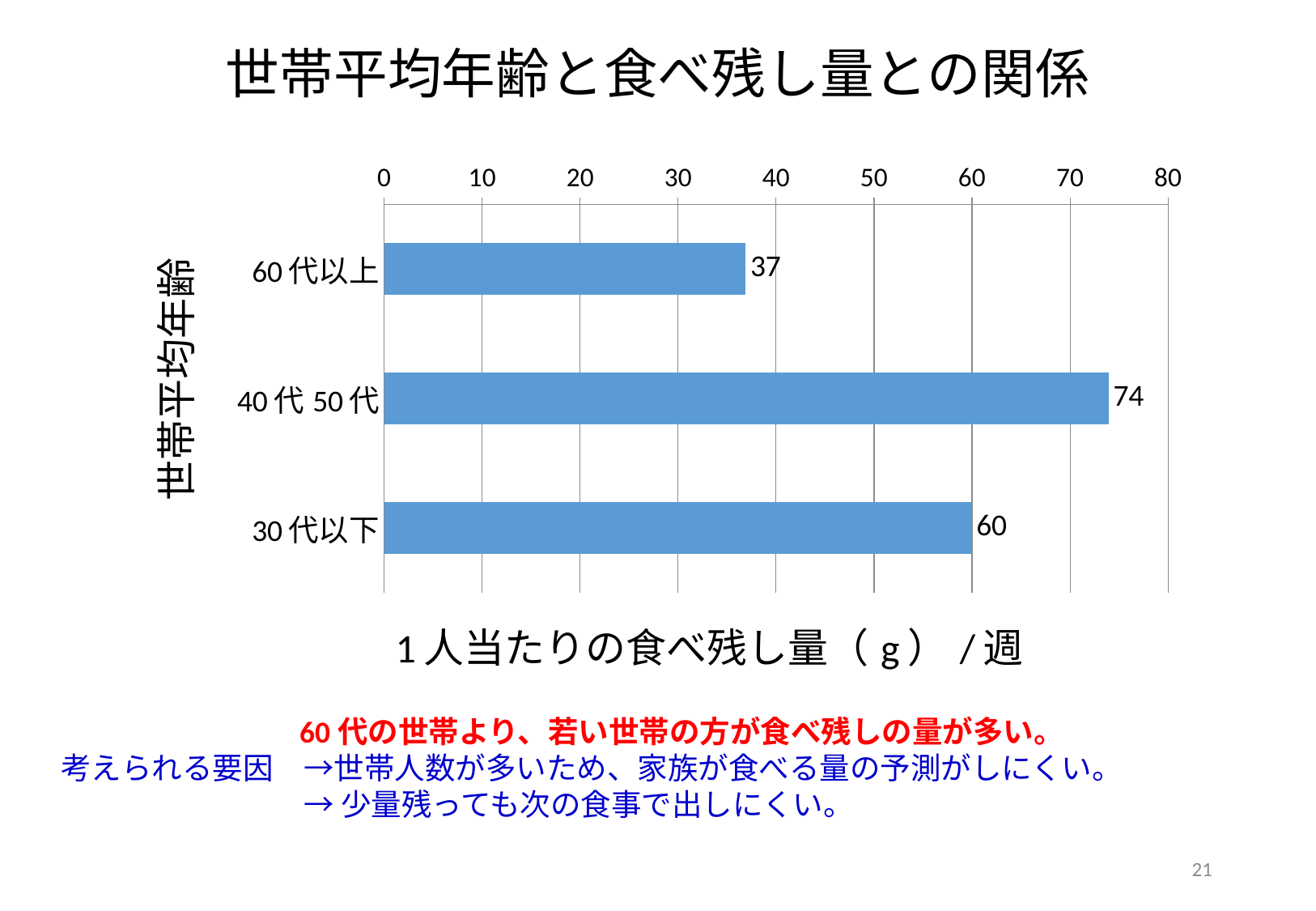
Which category has the highest value? 40代 50代 How many categories are shown in the chart? 3 What is the title of the slide's chart? 世帯平均年齢と食べ残し量との関係 What is the value for 40代 50代? 74 What kind of chart is shown on the slide? bar chart What is the value for 30代以下? 60 Is the value for 60代以上 greater or less than 40? less Which category has the lowest value? 60代以上 What is the difference between the values for 40代 50代 and 60代以上? 37 Which is larger, the value for 30代以下 or the value for 60代以上? 30代以下 What is the difference between the values for 40代 50代 and 30代以下? 14 What is the value for 60代以上? 37